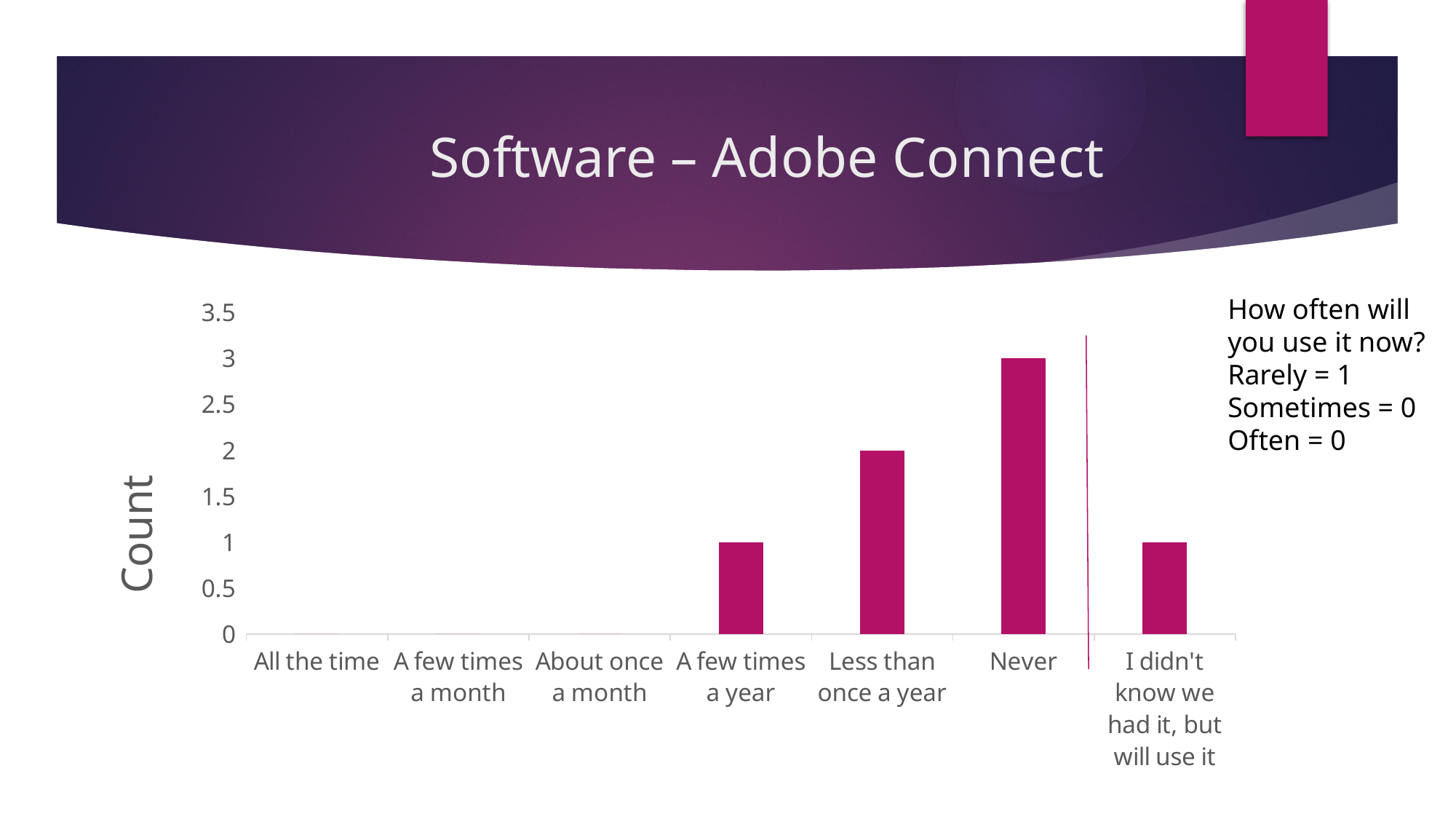
What is the difference between the counts for "Never" and "Less than once a year"? 1 How many categories are shown on the x axis? 7 What kind of chart is shown on the slide? Bar chart What is the count for "Never"? 3 What is the count for "Less than once a year"? 2 What is the label on the vertical axis? Count Which category has the highest count? Never What is the count for "A few times a year"? 1 What is the count for "I didn't know we had it, but will use it"? 1 Which has a larger count, "Less than once a year" or "A few times a year"? Less than once a year Is the count for "Never" greater or less than 2.5? greater What is the count for "All the time"? 0